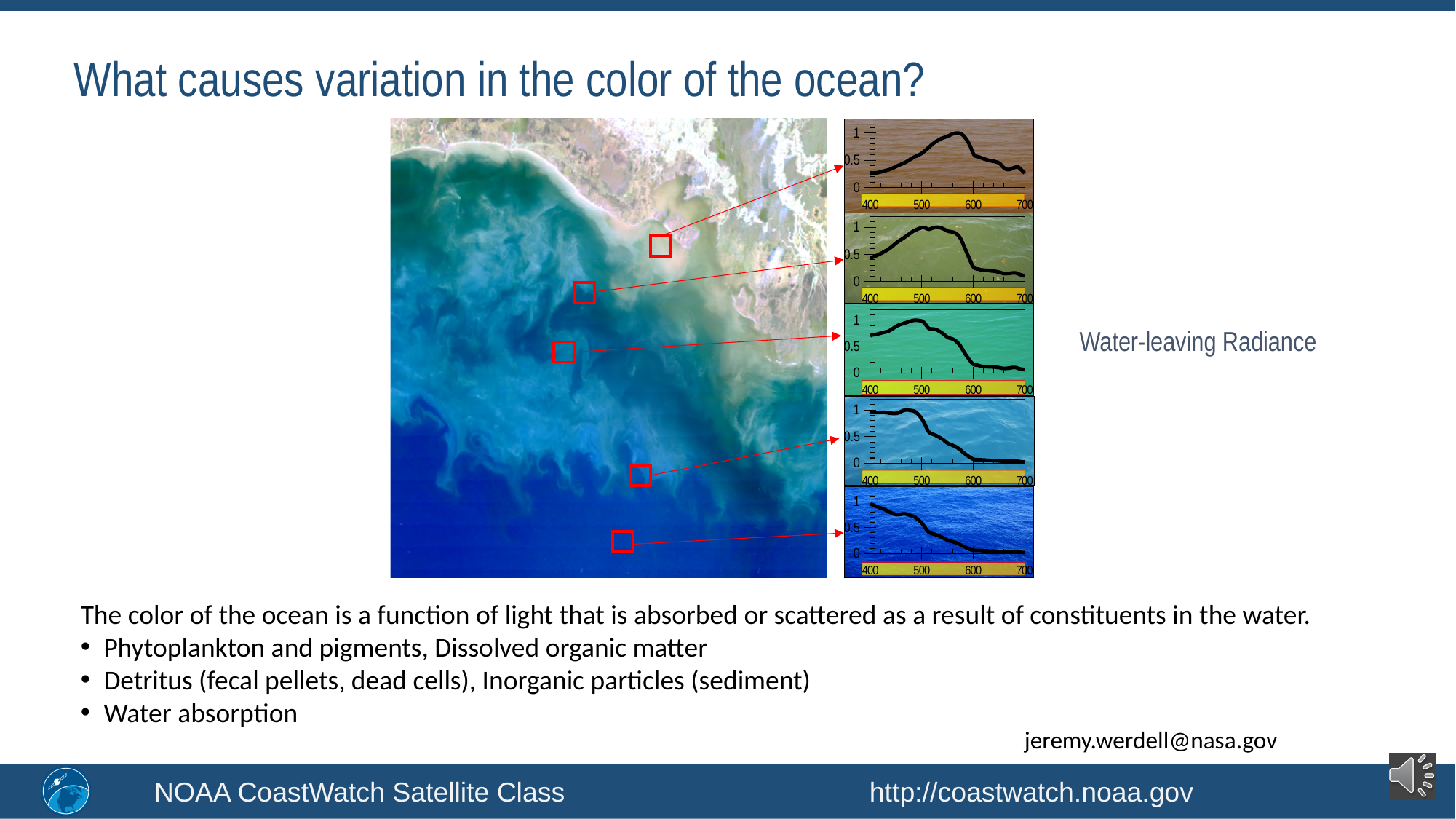
What is the highest x-axis tick value shown on the small radiance charts? 700 What kind of chart are the five small panels on the right side of the slide? line chart In the top (brown) chart, does the line rise or fall as the x axis goes from 400 to 550? rise In the top (brown) chart, is the value at 400 greater or less than 0.5? less In the bottom (dark blue) chart, is the value at 700 greater or less than 0.5? less How many small radiance charts are shown on the right side of the slide? 5 In the fourth (light blue) chart, is the value at 400 greater or less than 0.5? greater In the bottom (dark blue) chart, does the line rise or fall as the x axis goes from 400 to 700? fall What is the lowest x-axis tick value shown on the small radiance charts? 400 In the fourth (light blue) chart, does the line rise or fall as the x axis goes from 500 to 600? fall